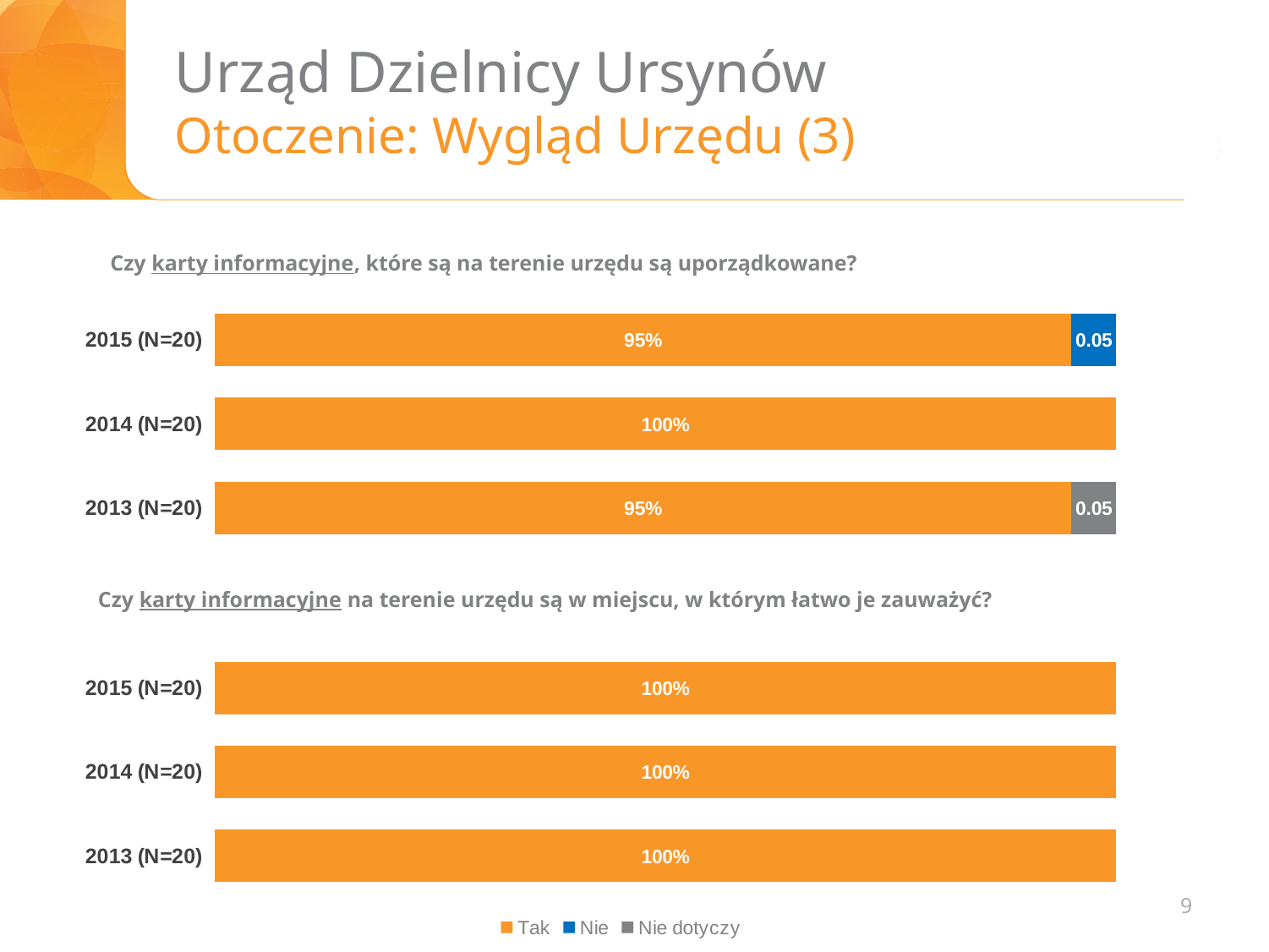
What type of chart is the top chart ("Czy karty informacyjne, które są na terenie urzędu są uporządkowane?")? Stacked horizontal bar chart In the top chart ("Czy karty informacyjne, które są na terenie urzędu są uporządkowane?"), which year has the highest Tak value? 2014 (N=20) In the bottom chart ("Czy karty informacyjne na terenie urzędu są w miejscu, w którym łatwo je zauważyć?"), how many year categories are shown? 3 In the top chart ("Czy karty informacyjne, które są na terenie urzędu są uporządkowane?"), what is the value of the Tak segment for 2014 (N=20)? 100% In the top chart ("Czy karty informacyjne, które są na terenie urzędu są uporządkowane?"), what value is printed on the blue Nie segment for 2015 (N=20)? 0.05 How many series does the legend at the bottom of the slide list? 3 In the top chart ("Czy karty informacyjne, które są na terenie urzędu są uporządkowane?"), what is the difference between the Tak value for 2014 (N=20) and the Tak value for 2015 (N=20)? 5% In the bottom chart ("Czy karty informacyjne na terenie urzędu są w miejscu, w którym łatwo je zauważyć?"), what is the Tak value for 2013 (N=20)? 100% Which colour represents the Tak series in the legend? Orange In the top chart ("Czy karty informacyjne, które są na terenie urzędu są uporządkowane?"), what is the value of the Tak segment for 2015 (N=20)? 95% In the top chart ("Czy karty informacyjne, które są na terenie urzędu są uporządkowane?"), what value is printed on the grey Nie dotyczy segment for 2013 (N=20)? 0.05 In the top chart ("Czy karty informacyjne, które są na terenie urzędu są uporządkowane?"), is the Tak value for 2014 (N=20) larger or smaller than the Tak value for 2013 (N=20)? larger